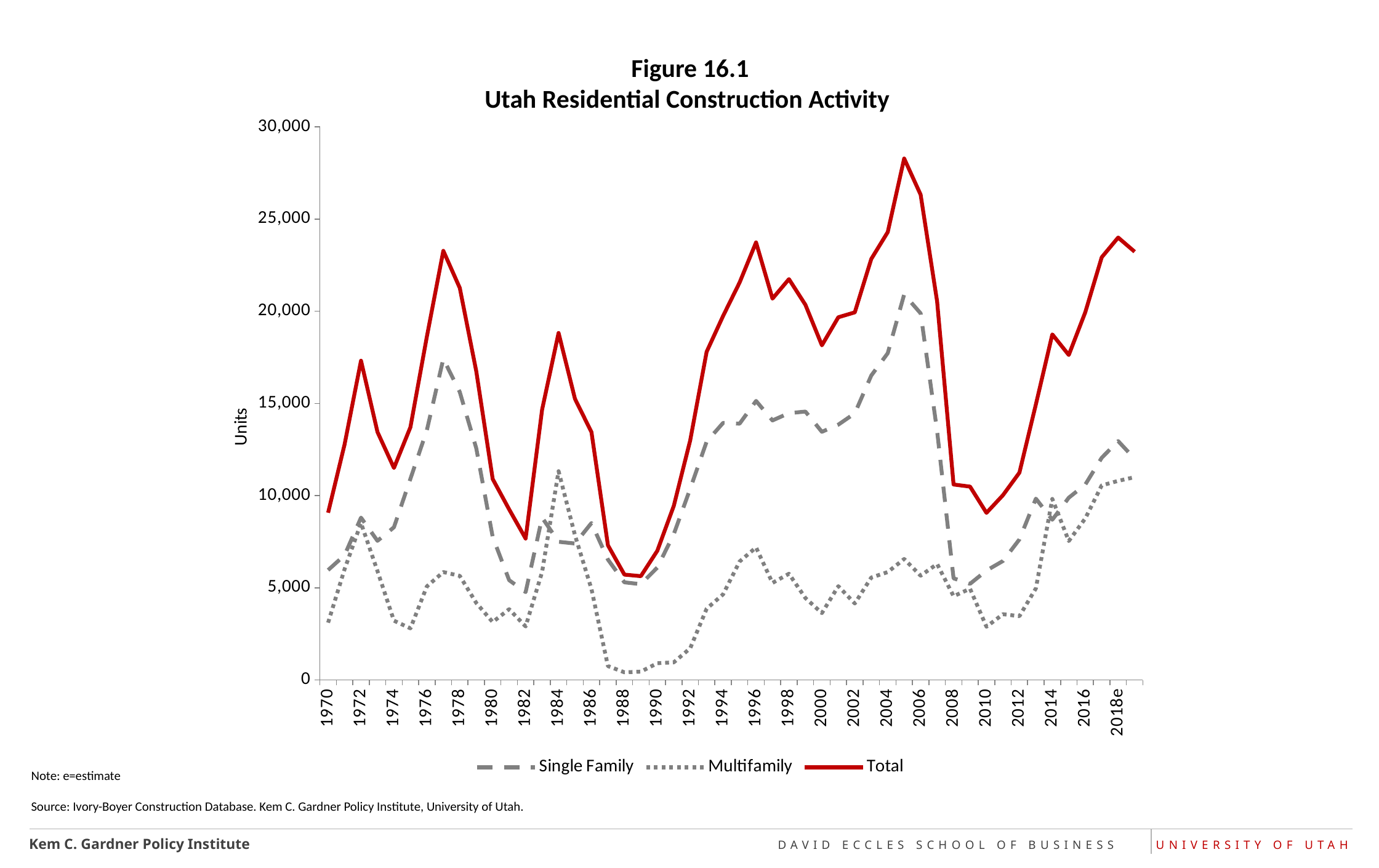
Does the Total series rise or fall from 2010 to 2018e? rise In which year does the Total series reach its highest value? 2005 What are the three series shown in the legend? Single Family, Multifamily, Total How many series does the legend list? 3 What is the title of the chart? Figure 16.1 Utah Residential Construction Activity Is the Total value in 2005 greater or less than 25,000? greater Is the Multifamily value in 1984 greater or less than 10,000? greater In 1984, which is larger: Single Family or Multifamily? Multifamily Is the Single Family value in 2005 greater or less than 15,000? greater What type of chart is shown in Figure 16.1? Line chart